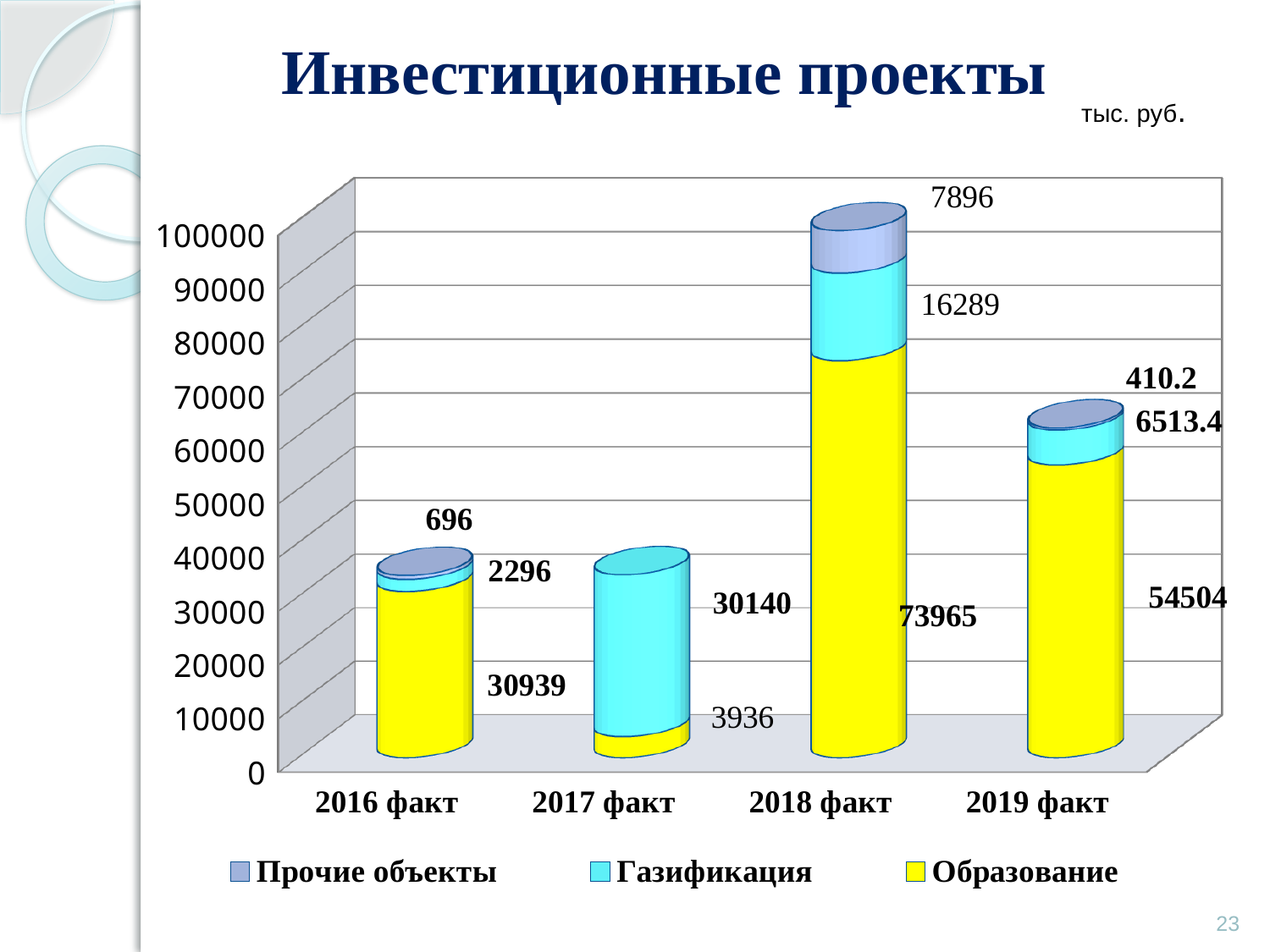
What is the value for Прочие объекты in 2019 факт? 410.2 In which year is the value for Газификация the lowest? 2016 факт In which year is the value for Образование the highest? 2018 факт How many categories are shown on the x axis? 4 What kind of chart is shown on the slide? Stacked bar chart What is the difference between the Образование values for 2018 факт and 2019 факт? 19461 What is the value for Газификация in 2017 факт? 30140 What is the value for Образование in 2018 факт? 73965 What unit is indicated for the values in the chart? тыс. руб. Which has the larger Газификация value, 2018 факт or 2019 факт? 2018 факт How many series does the legend list? 3 What is the total of the stacked bar for 2018 факт? 98150